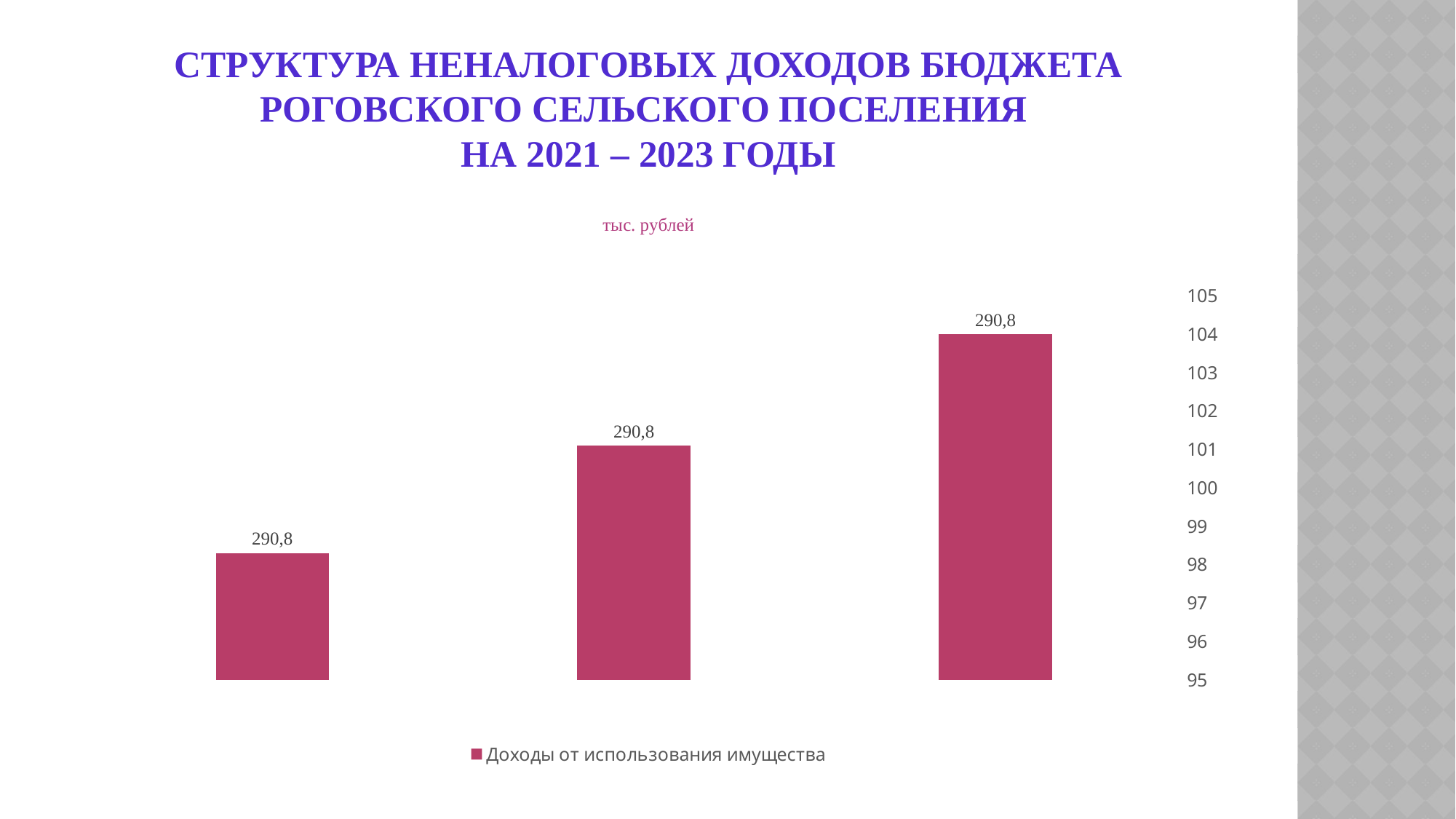
Do the bar heights rise or fall from left to right? rise How many bars are plotted in the chart? 3 What is the data label on the leftmost bar? 290,8 What is the data label on the rightmost bar? 290,8 What series name is shown in the legend? Доходы от использования имущества What is the data label on the middle bar? 290,8 What is the highest value shown on the vertical axis? 105 What unit is stated above the chart? тыс. рублей What is the lowest value shown on the vertical axis? 95 What kind of chart is shown on the slide? bar chart How many series does the legend list? 1